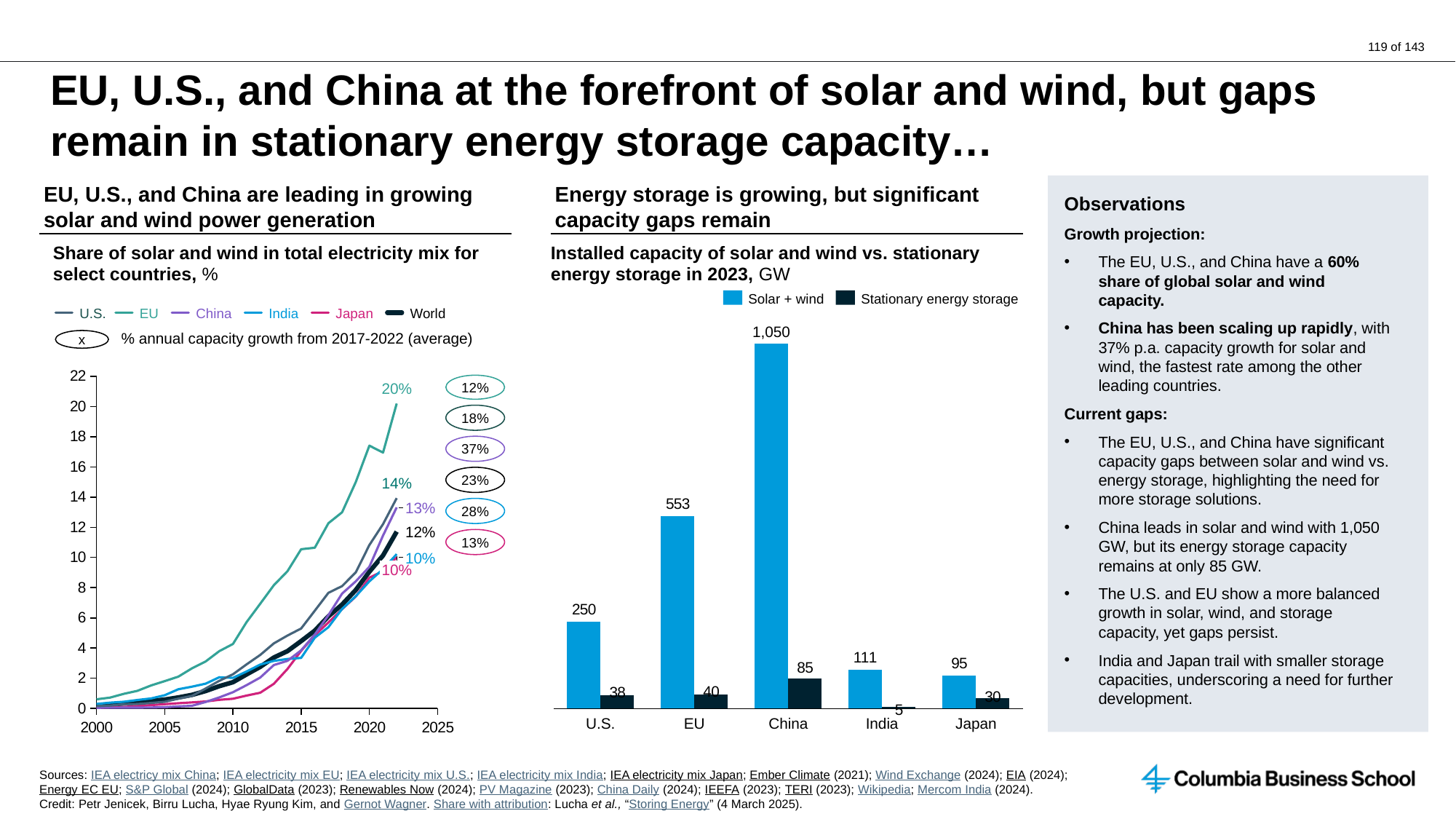
How many series does the legend of the bar chart on the right list? 2 In the bar chart on the right, what is the installed solar + wind capacity for China in 2023? 1,050 In the bar chart on the right, which is larger: the solar + wind capacity of the U.S. or of India? U.S. In the bar chart on the right, which country has the highest solar + wind capacity? China In the bar chart on the right, which country has the lowest stationary energy storage capacity? India In the bar chart on the right, what is the stationary energy storage capacity for the EU? 40 In the line chart on the left, which country has the highest average annual capacity growth from 2017-2022? China How many series does the legend of the line chart on the left list? 6 How many countries are shown on the x axis of the bar chart on the right? 5 What type of chart is the chart on the right showing installed capacity in 2023? Bar chart In the bar chart on the right, what is the difference between China's solar + wind capacity and its stationary energy storage capacity? 965 In the line chart on the left, what share of solar and wind in the electricity mix does the EU reach at the end of the series? 20%